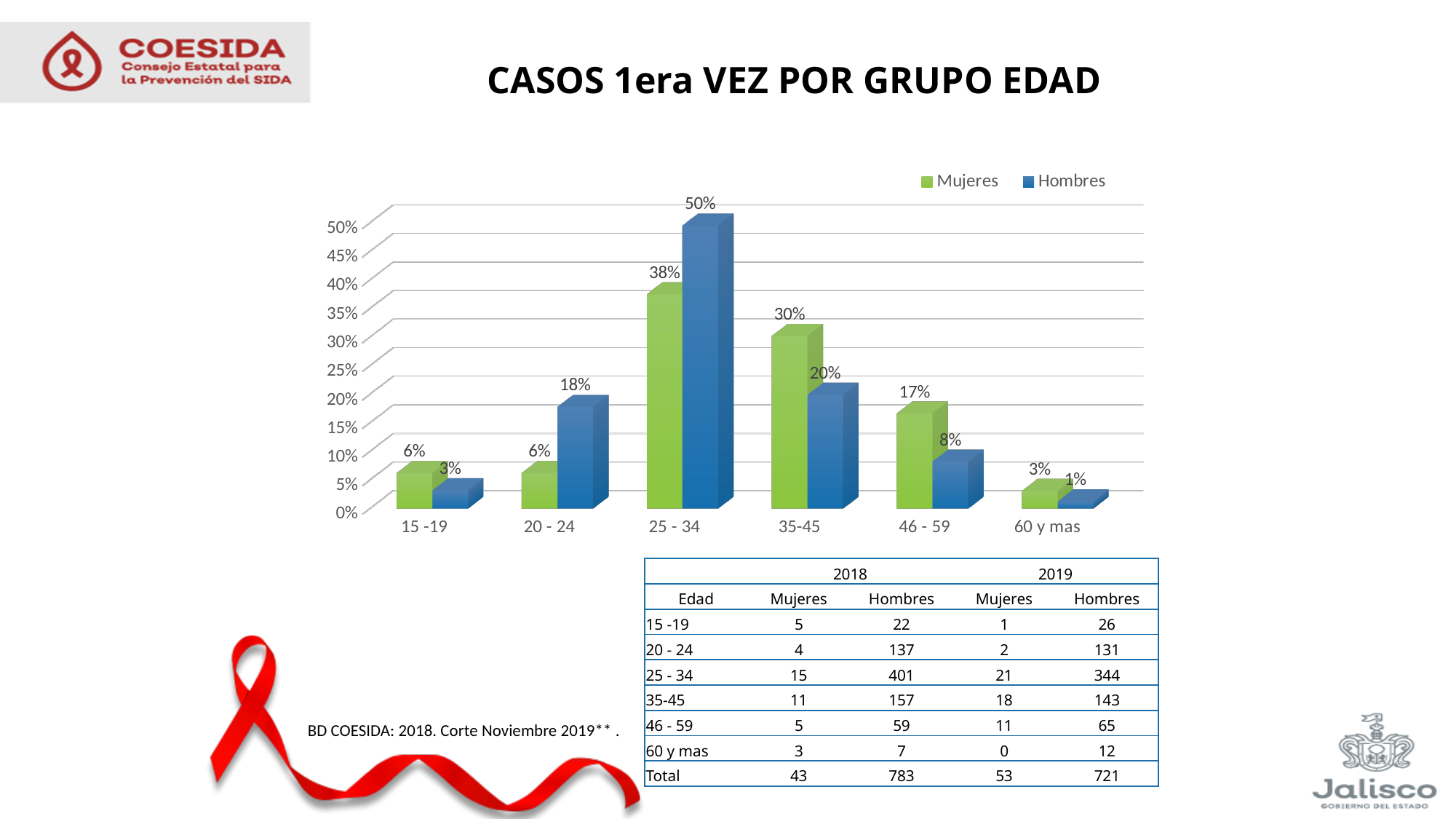
Which age group has the lowest value for Hombres? 60 y mas How many series does the chart legend list? 2 What kind of chart is shown on the slide? Bar chart What is the title of the chart? CASOS 1era VEZ POR GRUPO EDAD Which age group has the highest value for Mujeres? 25 - 34 What is the value for Hombres in the 25 - 34 age group? 50% What is the value for Mujeres in the 35-45 age group? 30% How many age groups are shown on the x axis of the chart? 6 Do the Hombres values rise or fall from the 25 - 34 age group to the 60 y mas age group? Fall Which is larger in the 46 - 59 age group, Mujeres or Hombres? Mujeres What is the value for Hombres in the 20 - 24 age group? 18% What is the difference between the Hombres and Mujeres values in the 25 - 34 age group? 12%